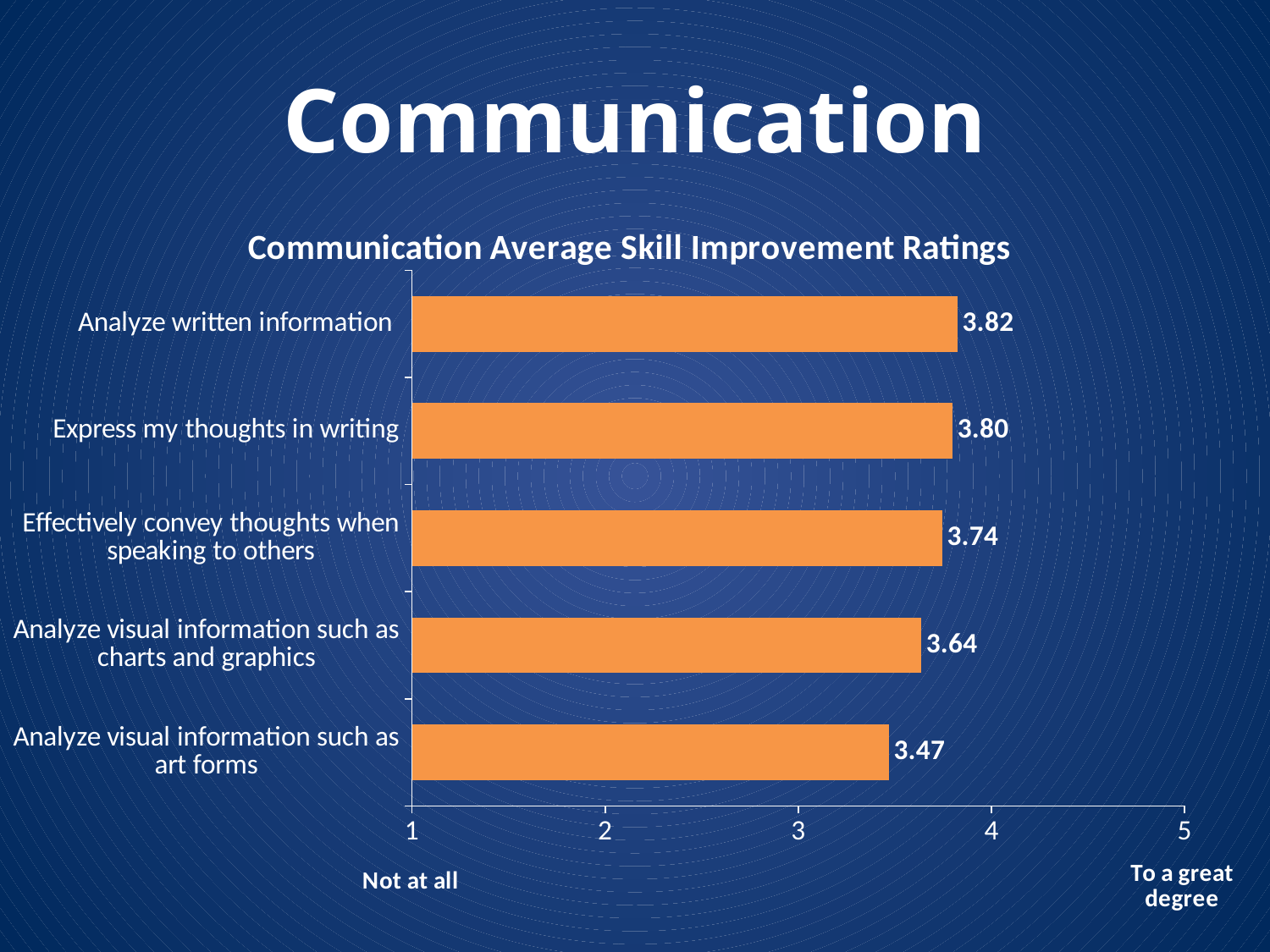
How many skill categories are shown in the chart? 5 Which has a higher rating: 'Effectively convey thoughts when speaking to others' or 'Analyze visual information such as charts and graphics'? Effectively convey thoughts when speaking to others Is the rating for 'Analyze visual information such as charts and graphics' greater or less than 4? less Which skill has the lowest average improvement rating? Analyze visual information such as art forms What is the rating for 'Effectively convey thoughts when speaking to others'? 3.74 Which skill has the highest average improvement rating? Analyze written information What is the average skill improvement rating for 'Analyze written information'? 3.82 What is the difference between the ratings for 'Analyze written information' and 'Analyze visual information such as art forms'? 0.35 What is the rating for 'Analyze visual information such as art forms'? 3.47 What is the title of the chart? Communication Average Skill Improvement Ratings What type of chart is shown on the slide? Bar chart What is the rating for 'Express my thoughts in writing'? 3.80